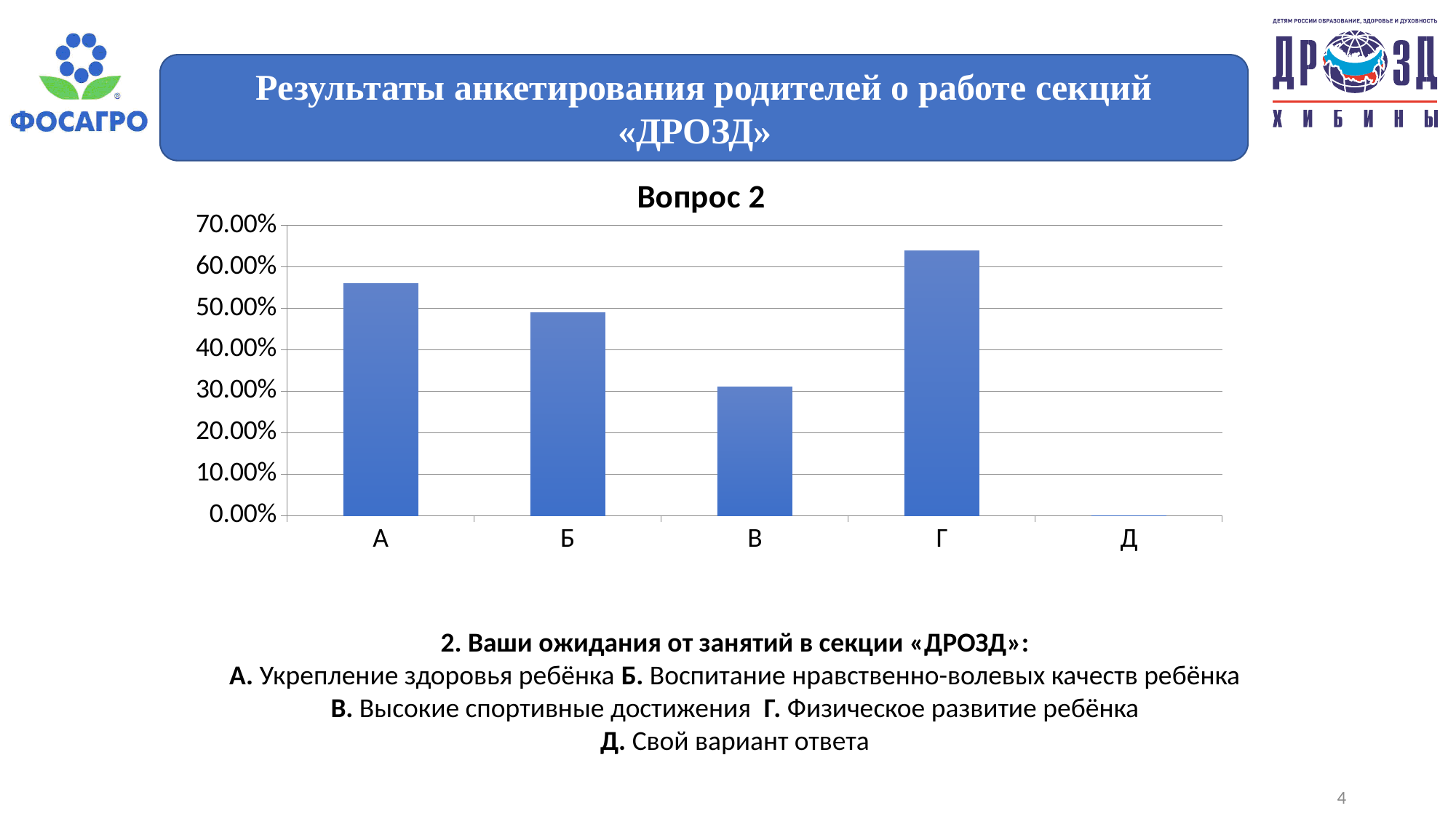
Is the value for В greater or less than 40.00%? less Is the value for А greater or less than 50.00%? greater How many categories are shown on the x axis of the chart? 5 Which category has the highest value in the chart? Г Which is larger, the value for В or the value for Г? Г Which category has the lowest value in the chart? Д Is the value for Б greater or less than 40.00%? greater What kind of chart is shown on the slide? bar chart What is the title of the chart? Вопрос 2 Which is larger, the value for А or the value for Б? А